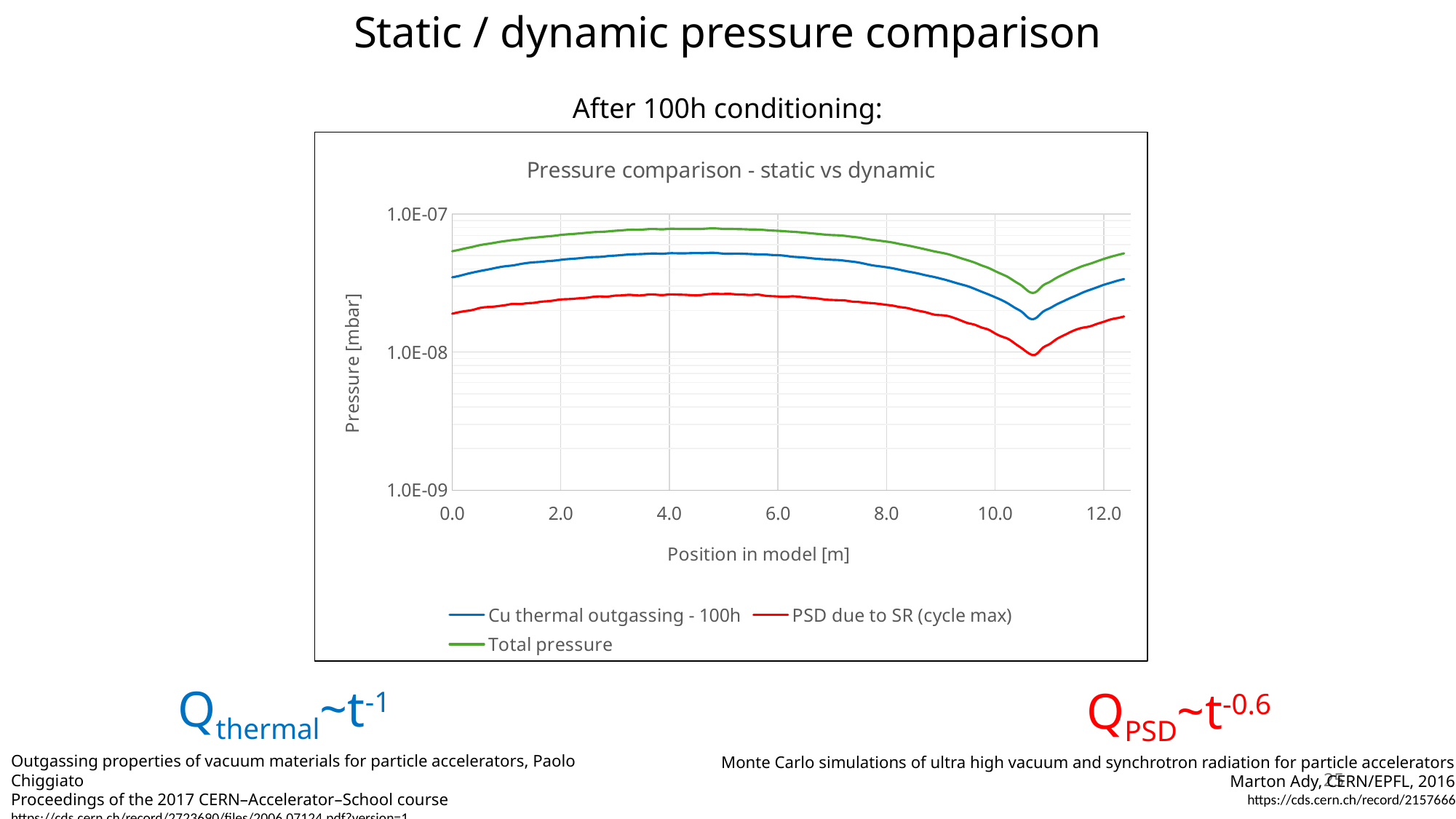
How many series does the chart's legend list? 3 What is the title of the chart? Pressure comparison - static vs dynamic Which series has the lowest pressure across the whole position range? PSD due to SR (cycle max) Which series has the highest pressure across the whole position range? Total pressure Is the PSD due to SR (cycle max) value at position 2.0 m greater or less than 1.0E-08 mbar? greater Is the Total pressure value at position 4.0 m greater or less than 1.0E-07 mbar? less Is the Cu thermal outgassing - 100h value at position 0.0 m greater or less than 1.0E-08 mbar? greater Does the Total pressure series rise or fall between positions 0.0 m and 4.0 m? rise At position 6.0 m, which is larger: Total pressure or Cu thermal outgassing - 100h? Total pressure Does the Cu thermal outgassing - 100h series rise or fall between positions 6.0 m and 10.0 m? fall What kind of chart is shown on the slide? line chart What is the label of the chart's x axis? Position in model [m]